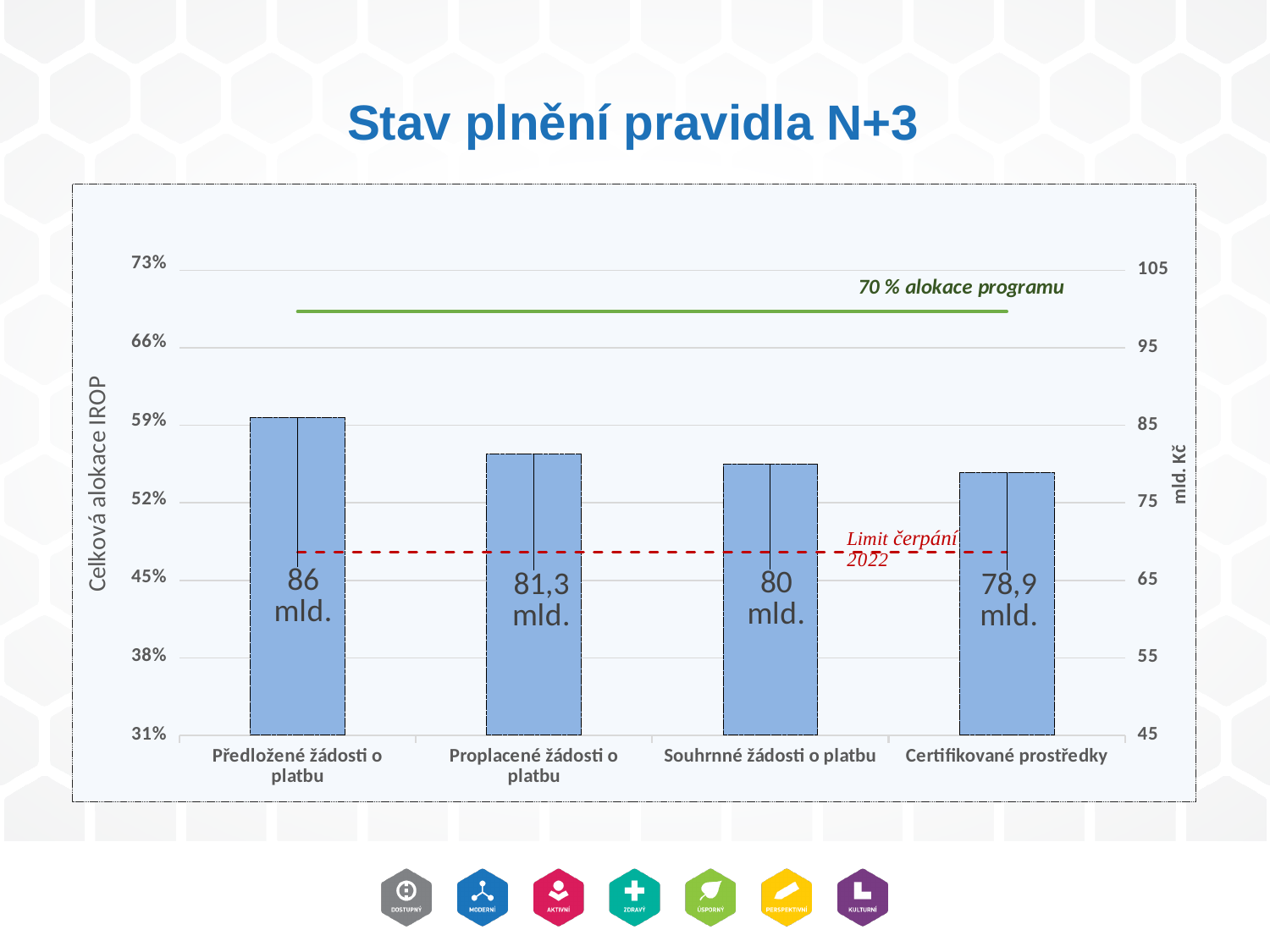
What is the difference between Předložené žádosti o platbu and Certifikované prostředky? 7,1 mld. What is the value for Souhrnné žádosti o platbu? 80 mld. What kind of chart is shown on the slide? Bar chart Which category has the highest value? Předložené žádosti o platbu Do the bar values rise or fall from left to right along the x axis? Fall How many categories are shown on the x axis? 4 What is the label of the green horizontal line on the chart? 70 % alokace programu What is the value for Certifikované prostředky? 78,9 mld. Which is larger, Proplacené žádosti o platbu or Souhrnné žádosti o platbu? Proplacené žádosti o platbu What is the value for Předložené žádosti o platbu? 86 mld. What is the value for Proplacené žádosti o platbu? 81,3 mld. Which category has the lowest value? Certifikované prostředky